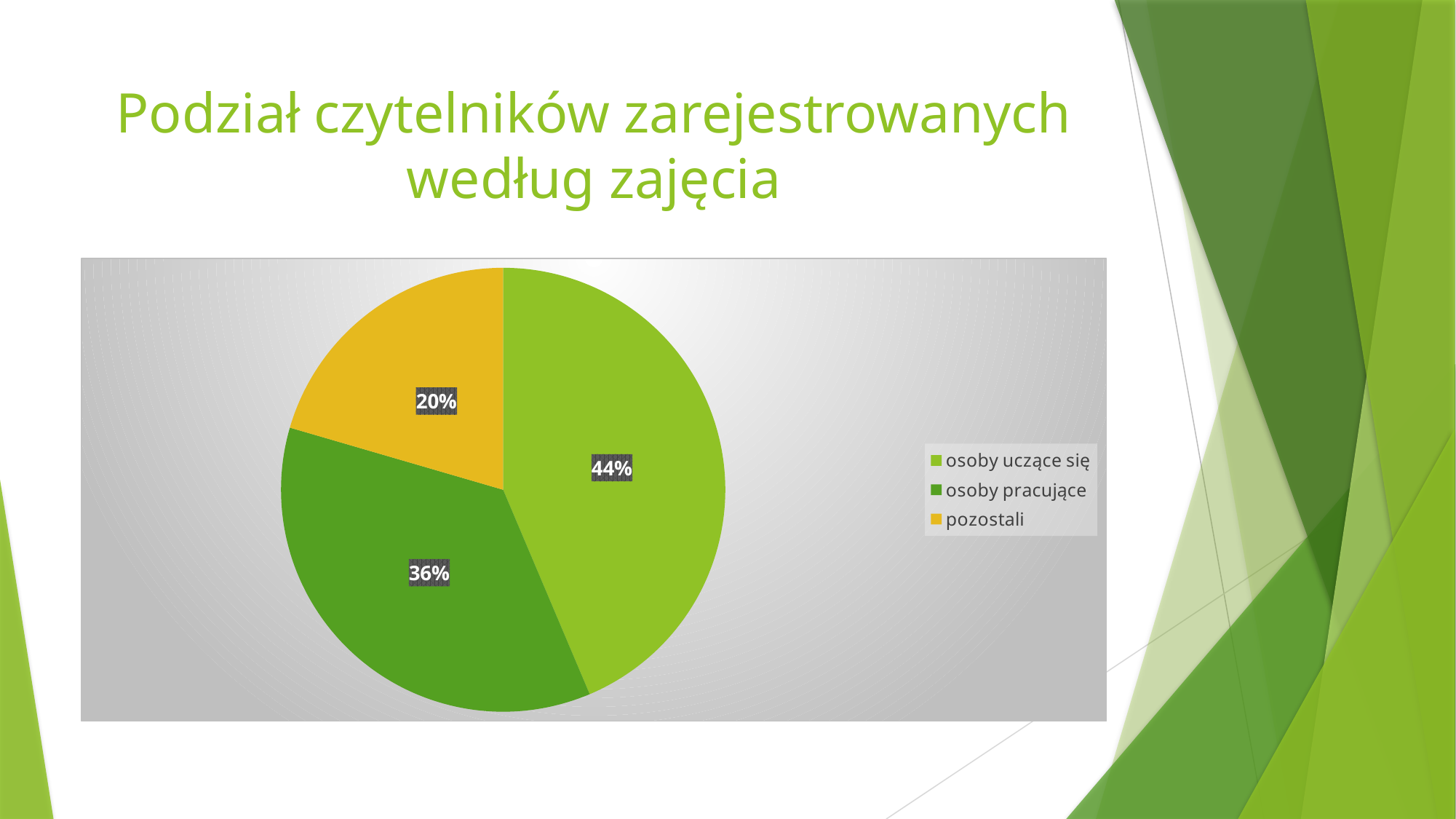
Which is larger: the share for "osoby pracujące" or the share for "pozostali"? osoby pracujące Which category has the smallest slice of the pie? pozostali Which legend entry is shown in yellow? pozostali What is the difference in percentage points between "osoby pracujące" and "pozostali"? 16 What share of the pie does "pozostali" have? 20% Which category has the largest slice of the pie? osoby uczące się What share of the pie does "osoby pracujące" have? 36% What is the title of the slide containing the chart? Podział czytelników zarejestrowanych według zajęcia What share of the pie does "osoby uczące się" have? 44% What kind of chart is shown on the slide? pie chart What is the difference in percentage points between "osoby uczące się" and "osoby pracujące"? 8 How many categories does the pie chart have? 3